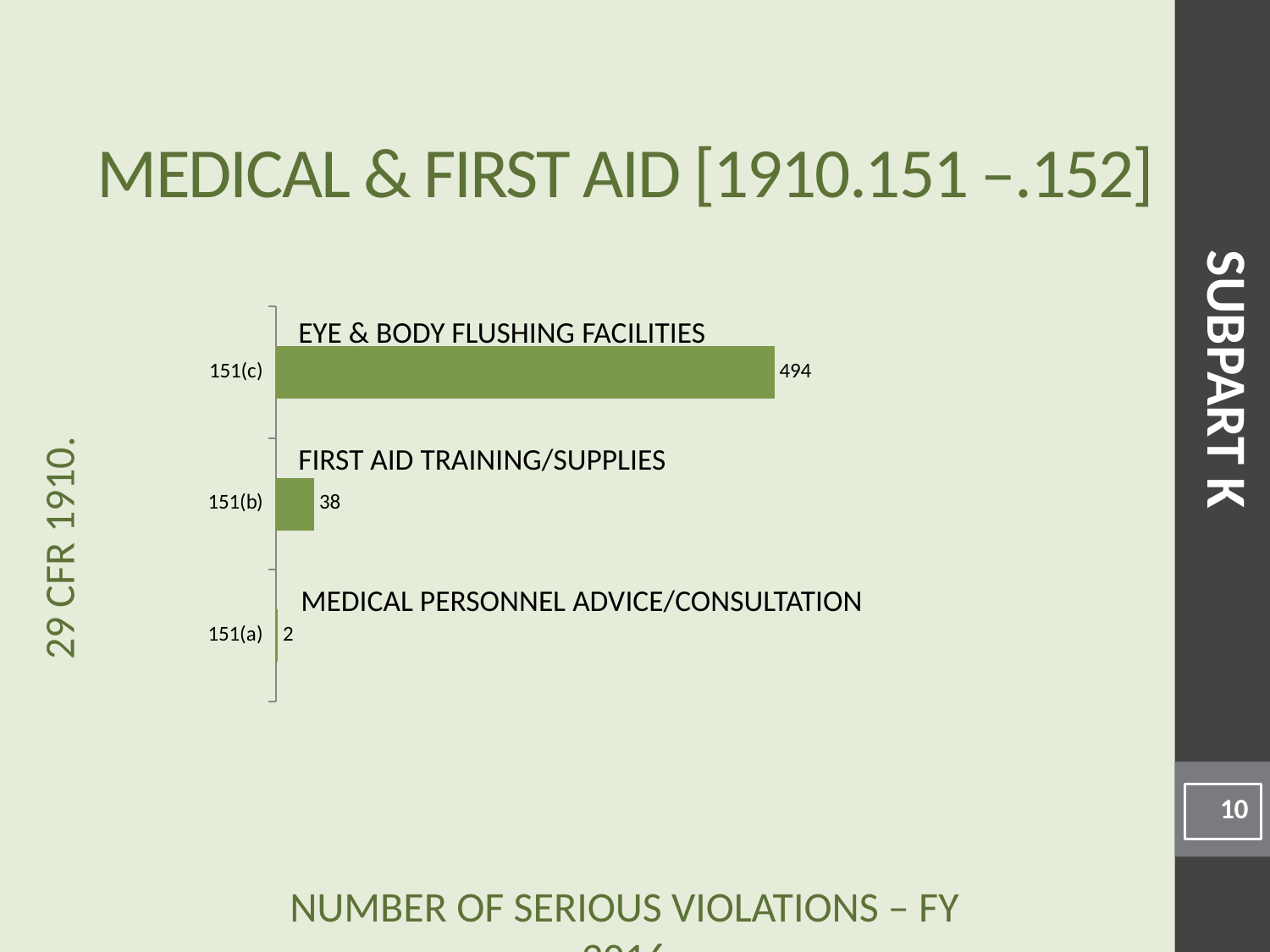
What is the number of serious violations for 151(a)? 2 Which has more serious violations, 151(b) or 151(a)? 151(b) What is the difference between the values for 151(c) and 151(b)? 456 What is the total number of serious violations across all three categories? 534 What is the difference between the values for 151(b) and 151(a)? 36 Which category is labelled 'EYE & BODY FLUSHING FACILITIES'? 151(c) How many categories are shown in the chart? 3 What is the number of serious violations for 151(c)? 494 Which category has the lowest number of serious violations? 151(a) Which category has the highest number of serious violations? 151(c) What is the number of serious violations for 151(b)? 38 What kind of chart is shown on the slide? Bar chart